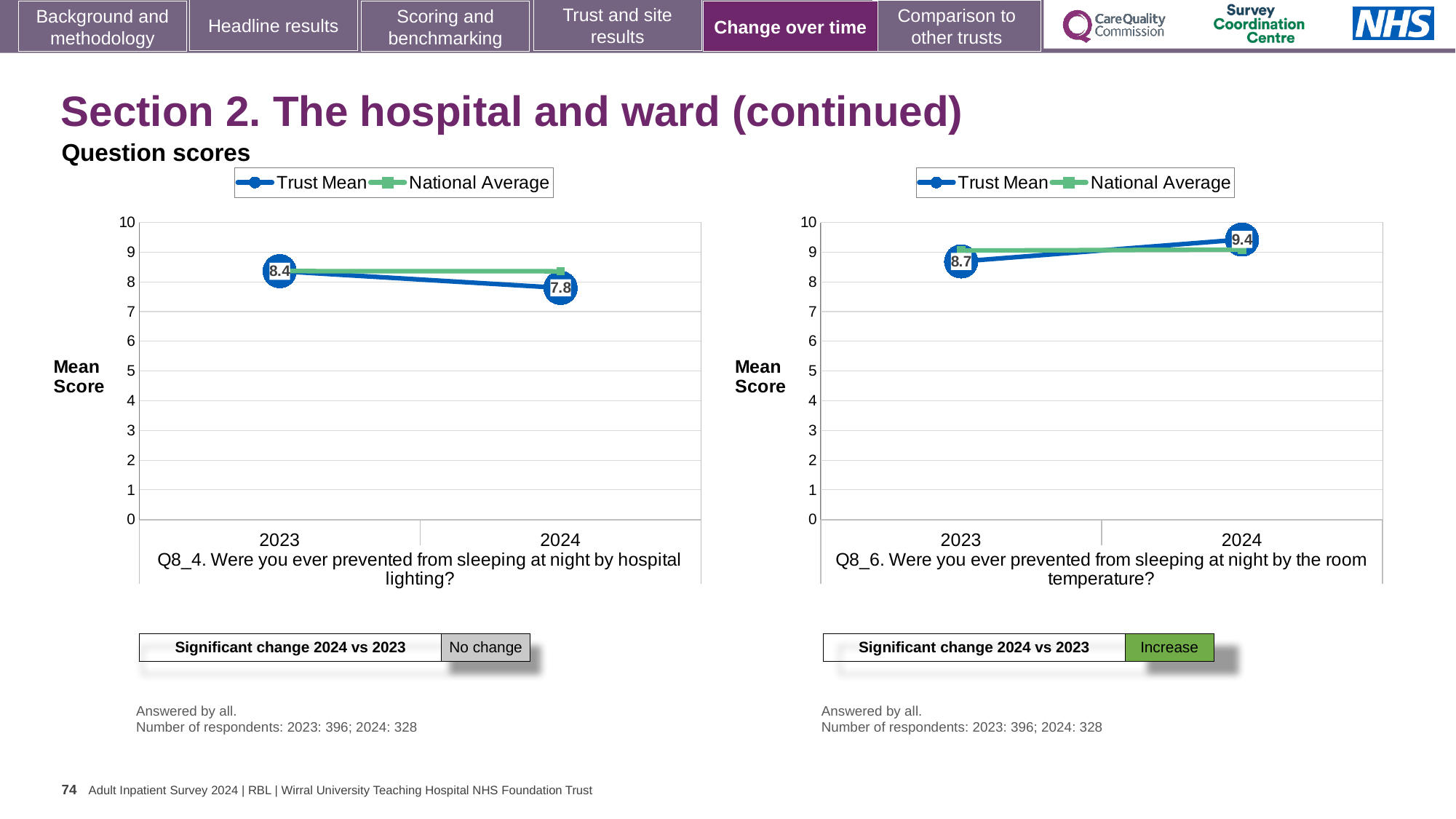
In the Q8_6 chart (right), does the Trust Mean rise or fall from 2023 to 2024? rise In the Q8_6 chart (right), is the National Average for 2024 greater or less than 8? greater In the Q8_6 chart (right), what is the Trust Mean for 2023? 8.7 In the Q8_4 chart (left), by how much did the Trust Mean change from 2023 to 2024? 0.6 In the Q8_6 chart (right), what is the difference between the Trust Mean in 2024 and in 2023? 0.7 In the Q8_6 chart (right), which is larger in 2024, the Trust Mean or the National Average? Trust Mean What kind of chart is the Q8_6 chart (right)? line chart In the Q8_4 chart (left), what is the Trust Mean for 2023? 8.4 In the Q8_4 chart (left), does the Trust Mean rise or fall from 2023 to 2024? fall In the Q8_4 chart (left), what is the Trust Mean for 2024? 7.8 In the Q8_6 chart (right), what is the Trust Mean for 2024? 9.4 How many series does the legend of the Q8_4 chart (left) list? 2